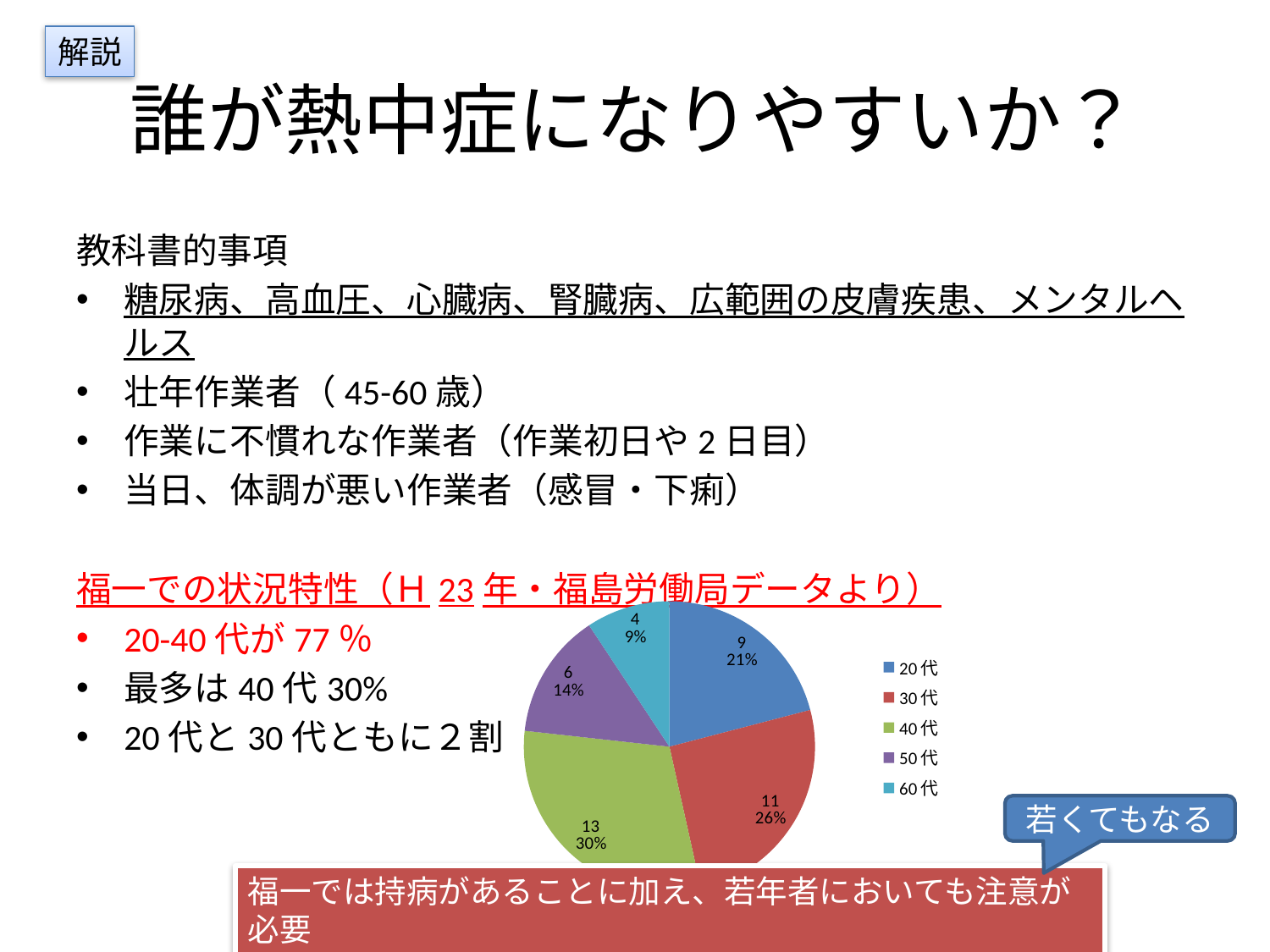
What is the difference between the counts for 40代 and 50代 in the pie chart? 7 Which age group has the smallest slice in the pie chart? 60代 How many slices does the pie chart have? 5 Which is larger in the pie chart, the count for 20代 or the count for 30代? 30代 What percentage share does 20代 have in the pie chart? 21% How many entries does the legend of the pie chart list? 5 What kind of chart is shown on the slide? pie chart What colour is the 50代 slice in the pie chart? purple What is the count shown for 40代 in the pie chart? 13 What percentage share does 30代 have in the pie chart? 26% Which age group has the largest slice in the pie chart? 40代 What is the count shown for 60代 in the pie chart? 4